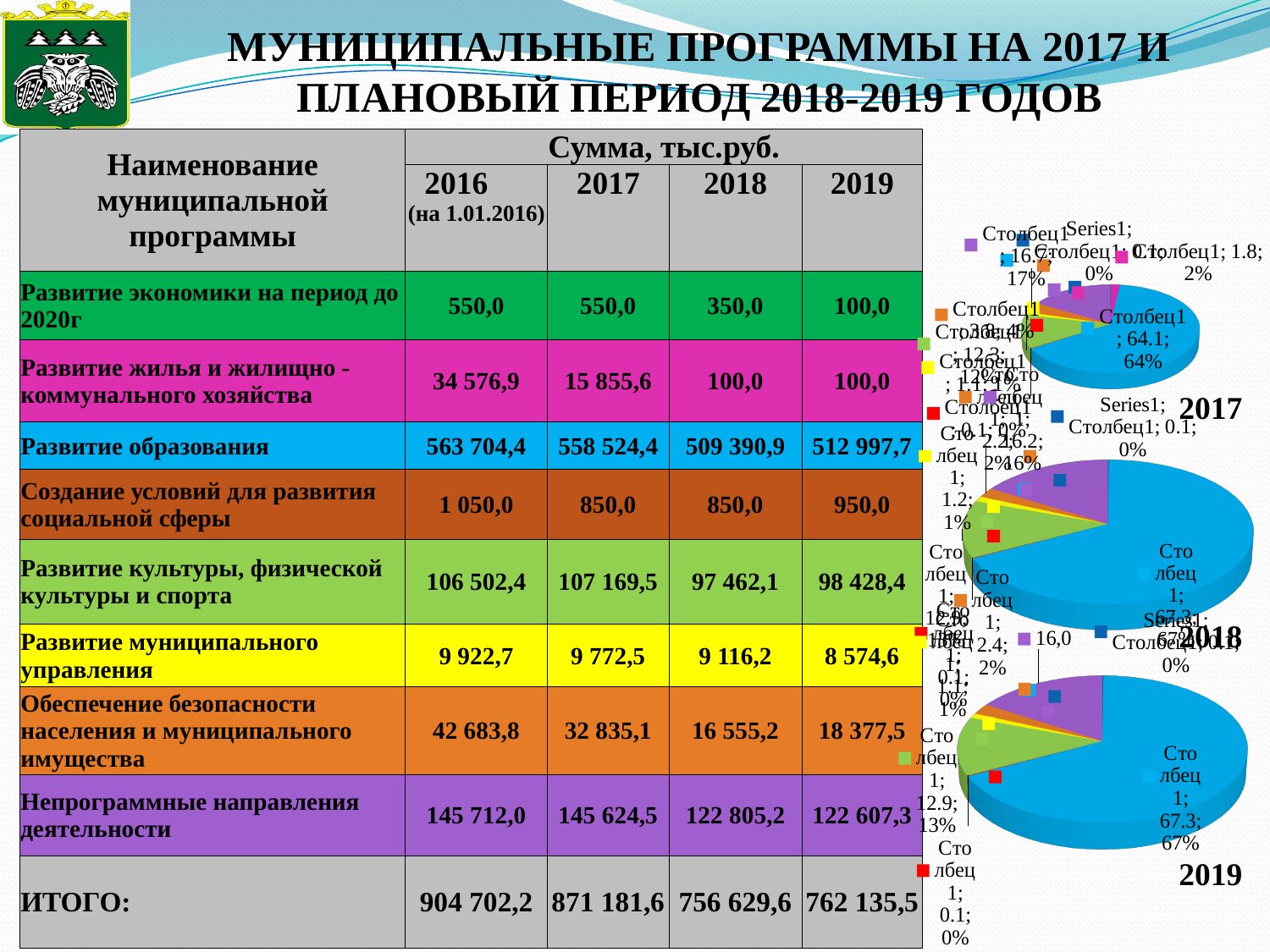
In the pie chart labelled 2019, what value is printed on the largest (blue) slice? 67.3 How many pie charts are shown on the slide? 3 What colour is the largest slice in each of the three pie charts? Blue Is the largest slice's share in the 2017 pie chart greater or less than 50%? greater In the pie chart labelled 2017, what percentage share does the largest slice have? 64% In the pie chart labelled 2018, what value is printed on the largest (blue) slice? 67.3 What kind of charts are shown on the right side of the slide? Pie charts Which pie chart has the larger share for its largest slice, 2017 or 2018? 2018 In the pie chart labelled 2017, what value is printed on the largest (blue) slice? 64.1 Which years are the three pie charts labelled with? 2017, 2018, 2019 In the pie chart labelled 2018, what percentage share does the largest slice have? 67% In the pie chart labelled 2019, what percentage share does the largest slice have? 67%